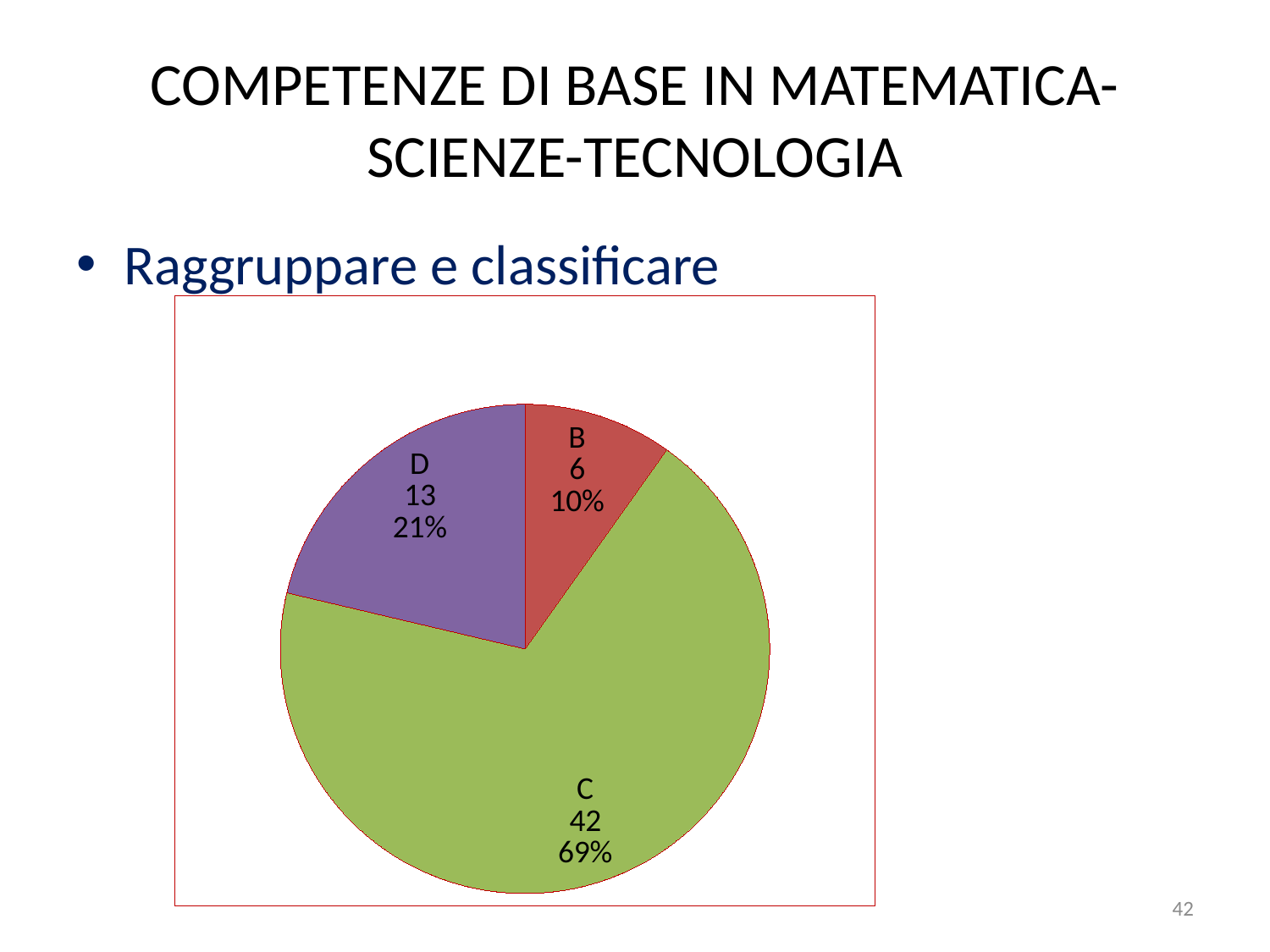
What share of the pie does category C represent? 69% Which category has the smallest slice? B What is the difference between the values for C and D? 29 How many slices does the pie chart have? 3 Which category has the largest slice? C What kind of chart is shown on the slide? pie chart What is the value for category C? 42 What share of the pie does category B represent? 10% What is the value for category B? 6 Which is larger, the value for D or the value for B? D What colour is the slice for category C? green What is the value for category D? 13